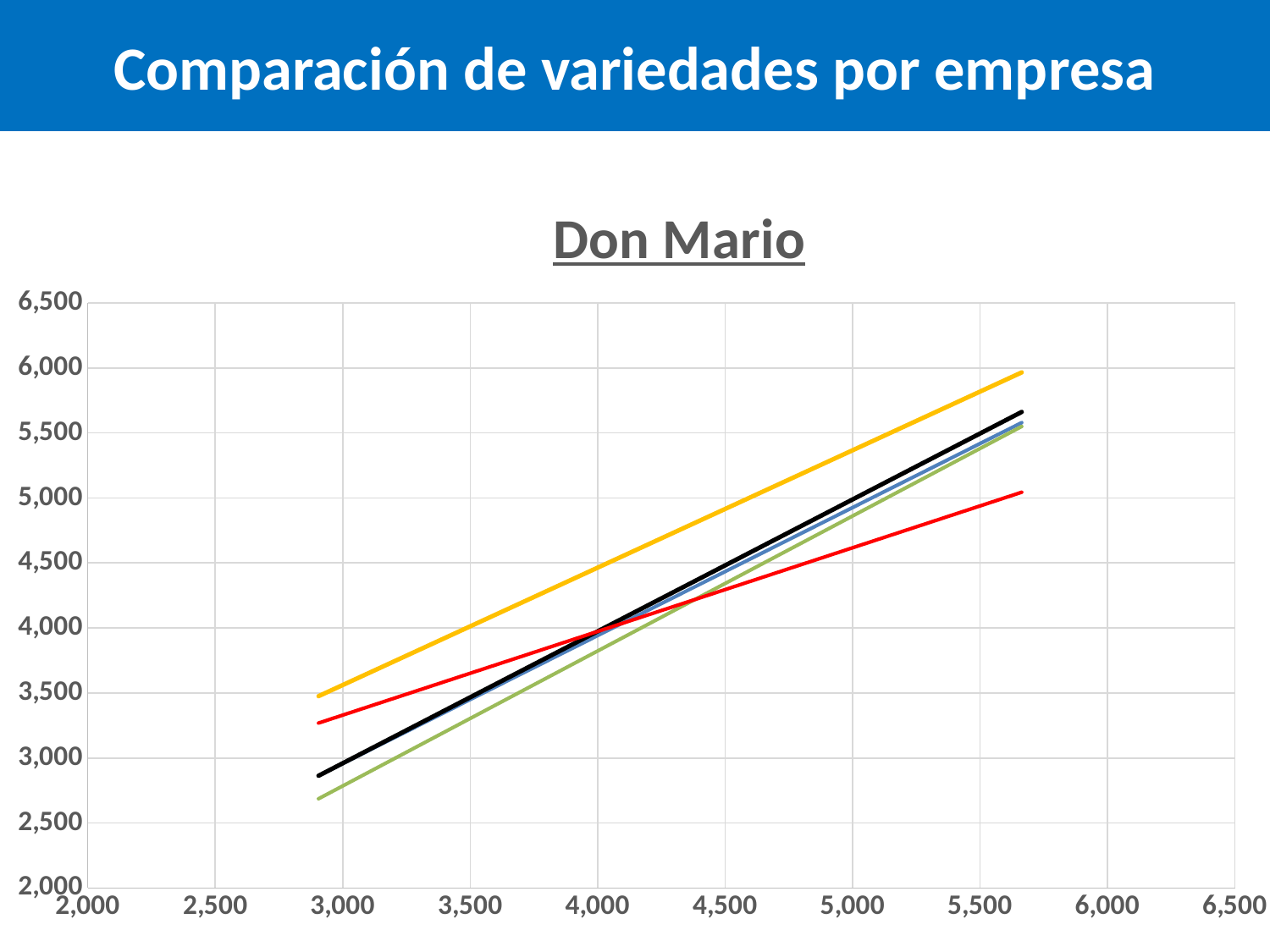
Which coloured line is the lowest at the left end of the chart? green What is the title of the chart? Don Mario Do the lines rise or fall as the x-axis value increases? rise How many lines are plotted on the chart? 5 Which coloured line is the highest at the right end of the chart? yellow Is the value of the red line at x = 5,000 greater or less than 5,000? less At x = 5,000, is the yellow line or the red line higher? yellow What is the highest value shown on the vertical axis? 6,500 At x = 3,000, is the red line or the black line higher? red Which coloured line is the lowest at the right end of the chart? red What kind of chart is shown on the slide? line chart Is the value of the yellow line at x = 5,500 greater or less than 5,500? greater